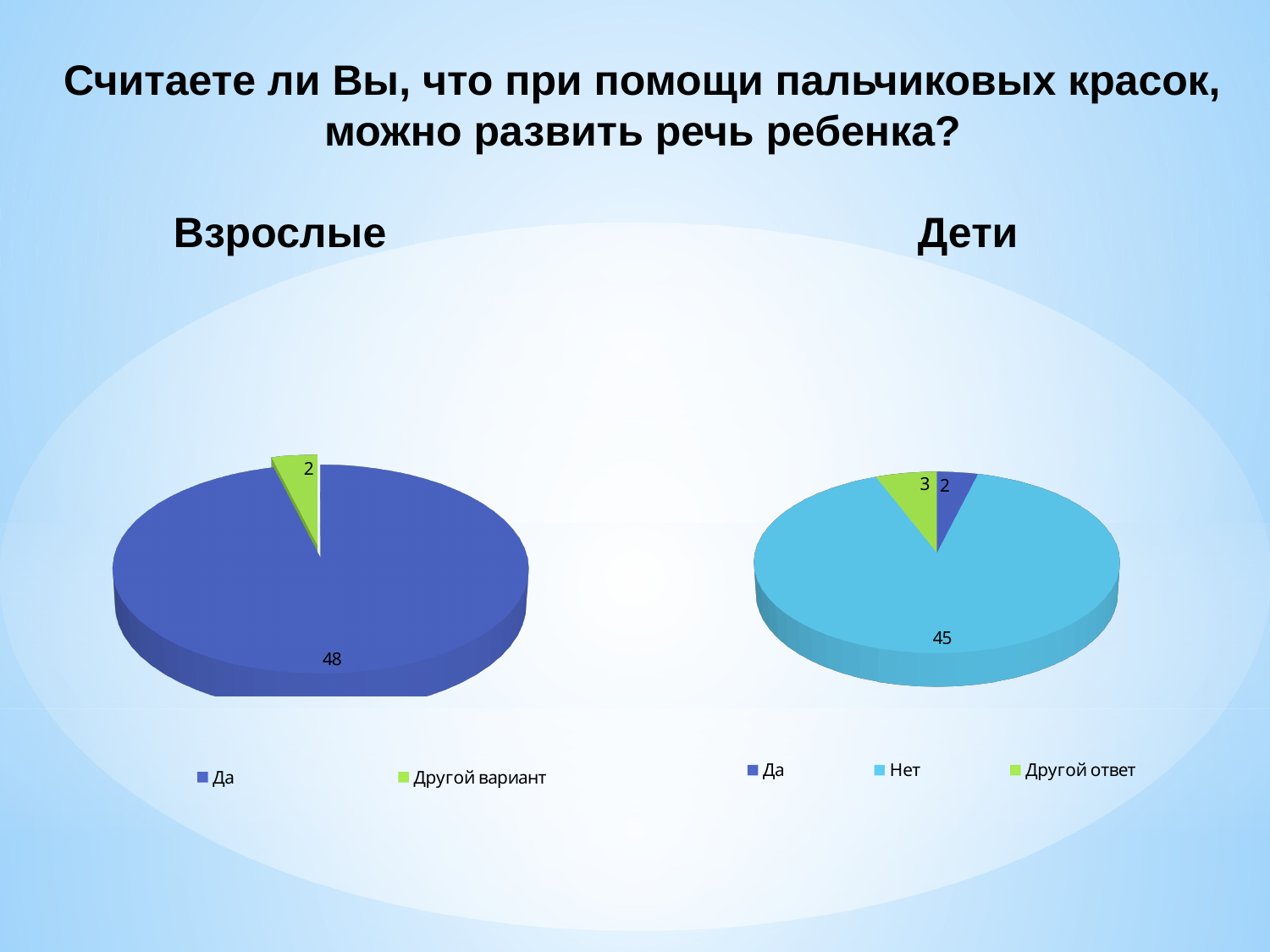
In the "Дети" chart, what is the value for "Нет"? 45 In the "Взрослые" chart, what is the value for "Да"? 48 In the "Взрослые" chart, what share of the pie does "Да" represent? 96% In the "Взрослые" chart, what is the difference between the values for "Да" and "Другой вариант"? 46 In the "Дети" chart, which category has the smallest slice? Да In the "Дети" chart, what is the value for "Другой ответ"? 3 In the "Дети" chart, which category has the largest slice? Нет In the "Взрослые" chart, what is the value for "Другой вариант"? 2 What kind of chart is used for the "Взрослые" data? Pie chart In the "Дети" chart, how many categories does the legend list? 3 In the "Дети" chart, what share of the pie does "Нет" represent? 90% In the "Дети" chart, what is the value for "Да"? 2